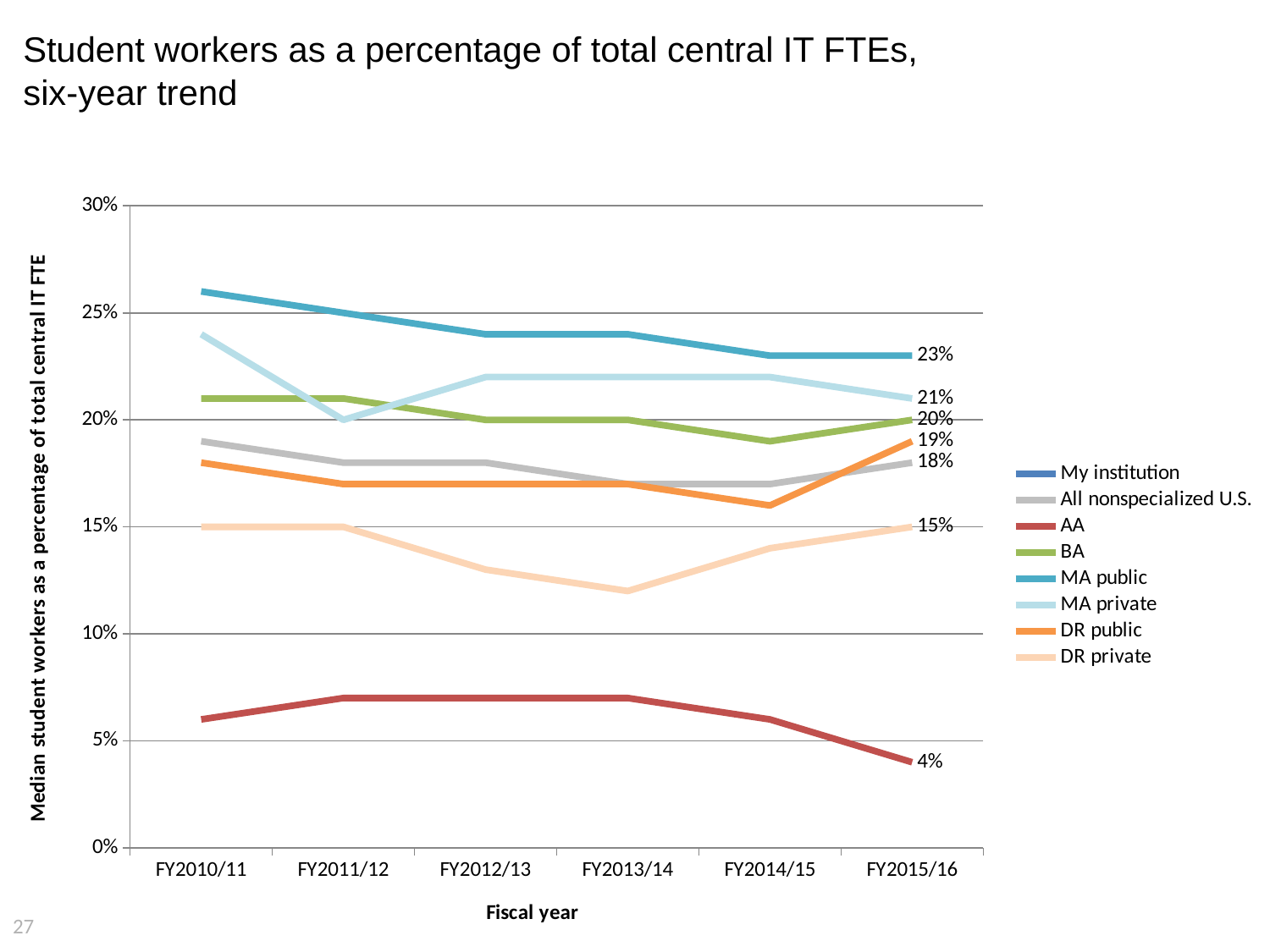
What kind of chart is shown on the slide? Line chart What is the value for AA in FY2015/16? 4% In FY2015/16, which is larger: DR public or All nonspecialized U.S.? DR public What is the value for DR private in FY2015/16? 15% Is the value for MA public in FY2010/11 greater or less than 25%? greater Which series has the lowest value in FY2015/16? AA How many series does the legend list? 8 How many fiscal years are shown on the x axis? 6 What is the difference between the MA public and AA values in FY2015/16? 19 percentage points What is the value for MA public in FY2015/16? 23% Is the value for DR private in FY2013/14 greater or less than 15%? less Which series has the highest value in FY2015/16? MA public